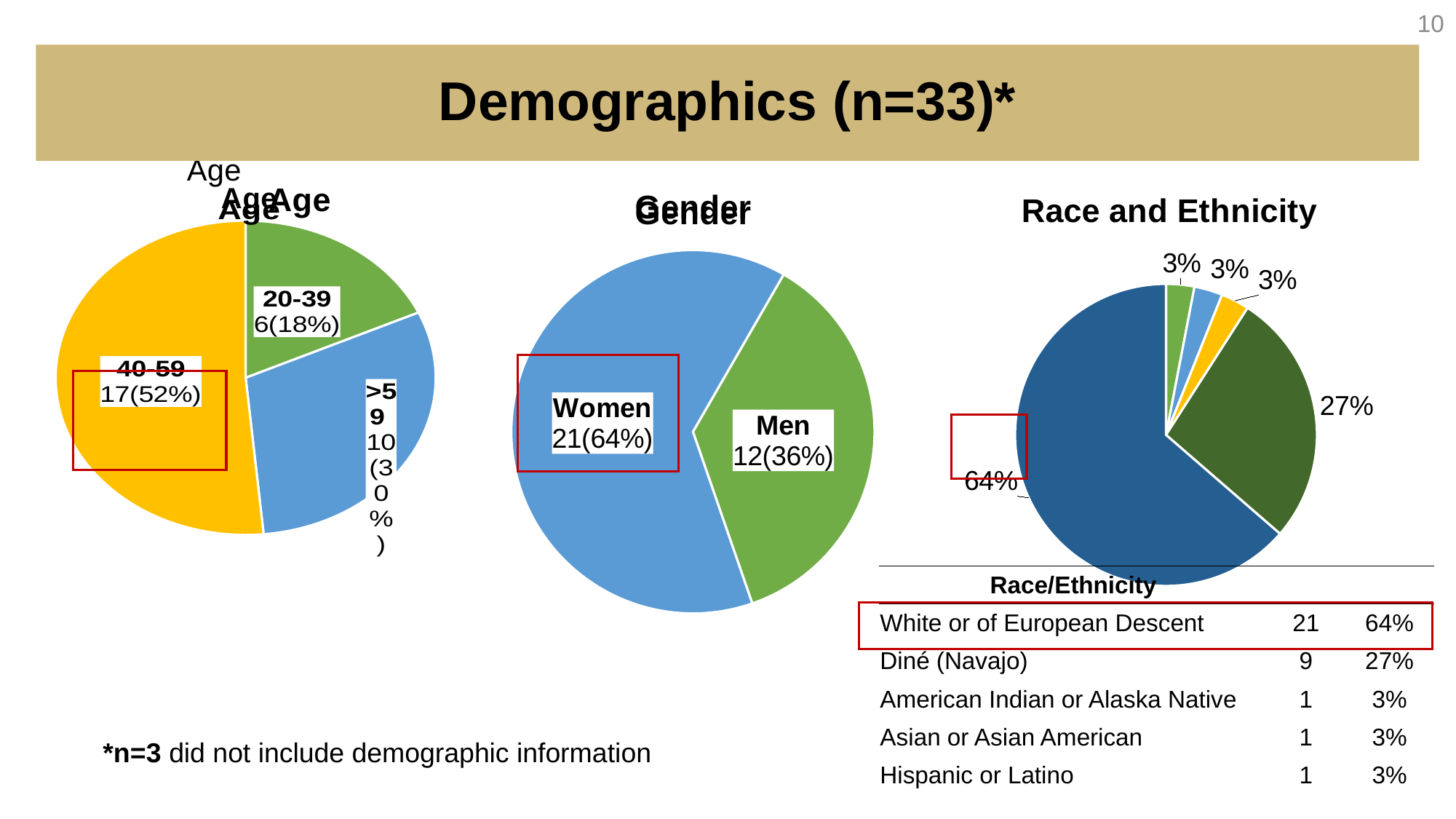
In the Gender chart, which group is larger, Women or Men? Women In the Gender chart, what is the difference in count between Women and Men? 9 In the Age chart, what is the label shown for the 40-59 slice? 17(52%) In the Gender chart, what is the label shown for Women? 21(64%) In the Age chart, how many age groups are shown? 3 In the Age chart, what is the label shown for the 20-39 slice? 6(18%) In the Age chart, which age group has the largest slice? 40-59 In the Age chart, which age group has the smallest slice? 20-39 In the Race and Ethnicity chart, what percentage is shown for Diné (Navajo)? 27% In the Race and Ethnicity chart, what percentage is shown for the largest slice? 64% What kind of chart is the Gender chart? Pie chart In the Gender chart, what is the label shown for Men? 12(36%)